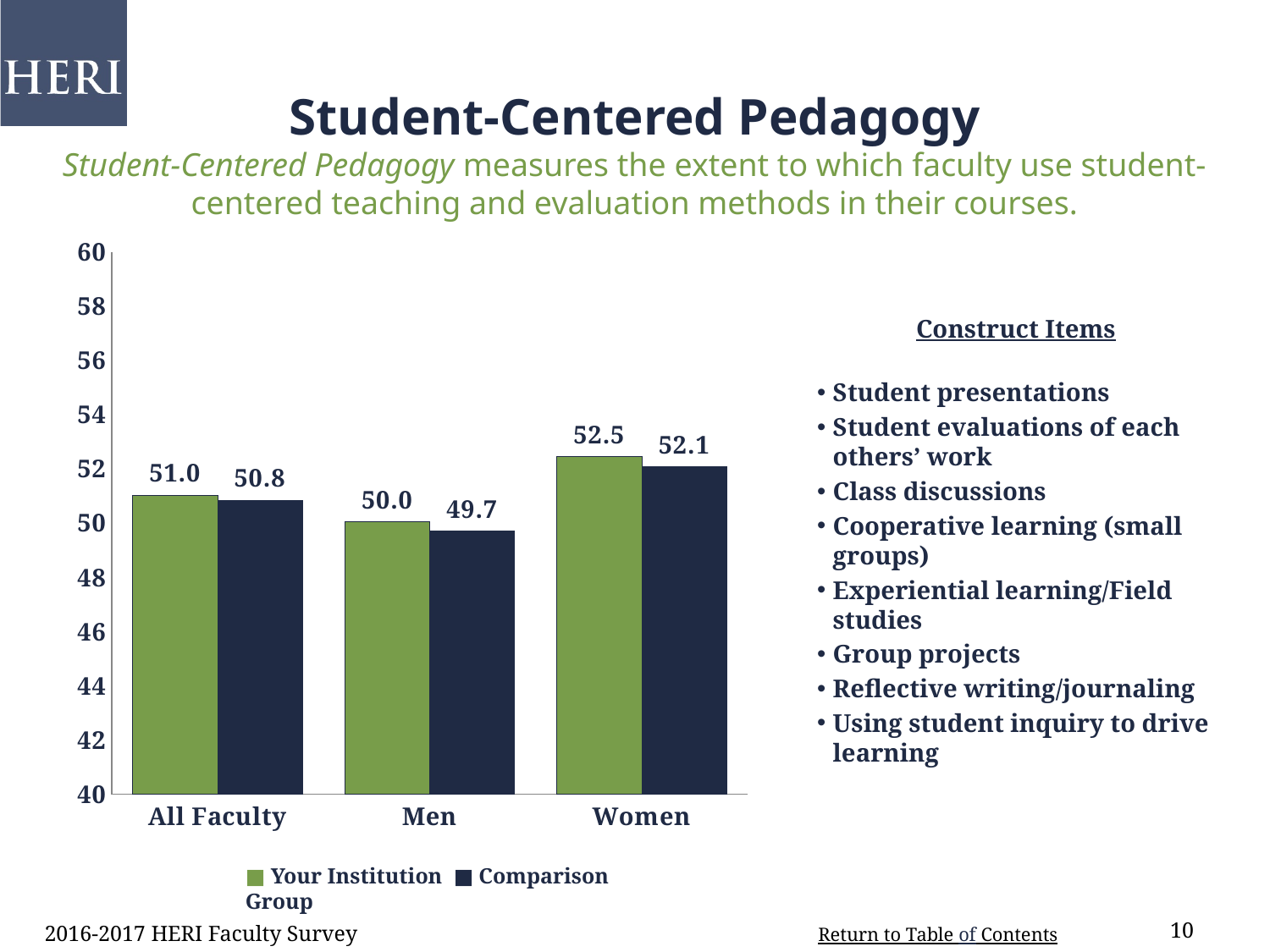
How many categories are shown on the x axis? 3 What kind of chart is shown on the slide? bar chart What is the difference between the Your Institution values for Women and All Faculty? 1.5 Which category has the lowest Your Institution value? Men Is the Comparison Group value for Men greater or less than 50? less Which is larger for Women: Your Institution or Comparison Group? Your Institution What is the Your Institution value for All Faculty? 51.0 What is the difference between the Your Institution and Comparison Group values for Men? 0.3 What is the Comparison Group value for Men? 49.7 Which category has the highest Comparison Group value? Women What is the Your Institution value for Women? 52.5 How many series does the legend list? 2